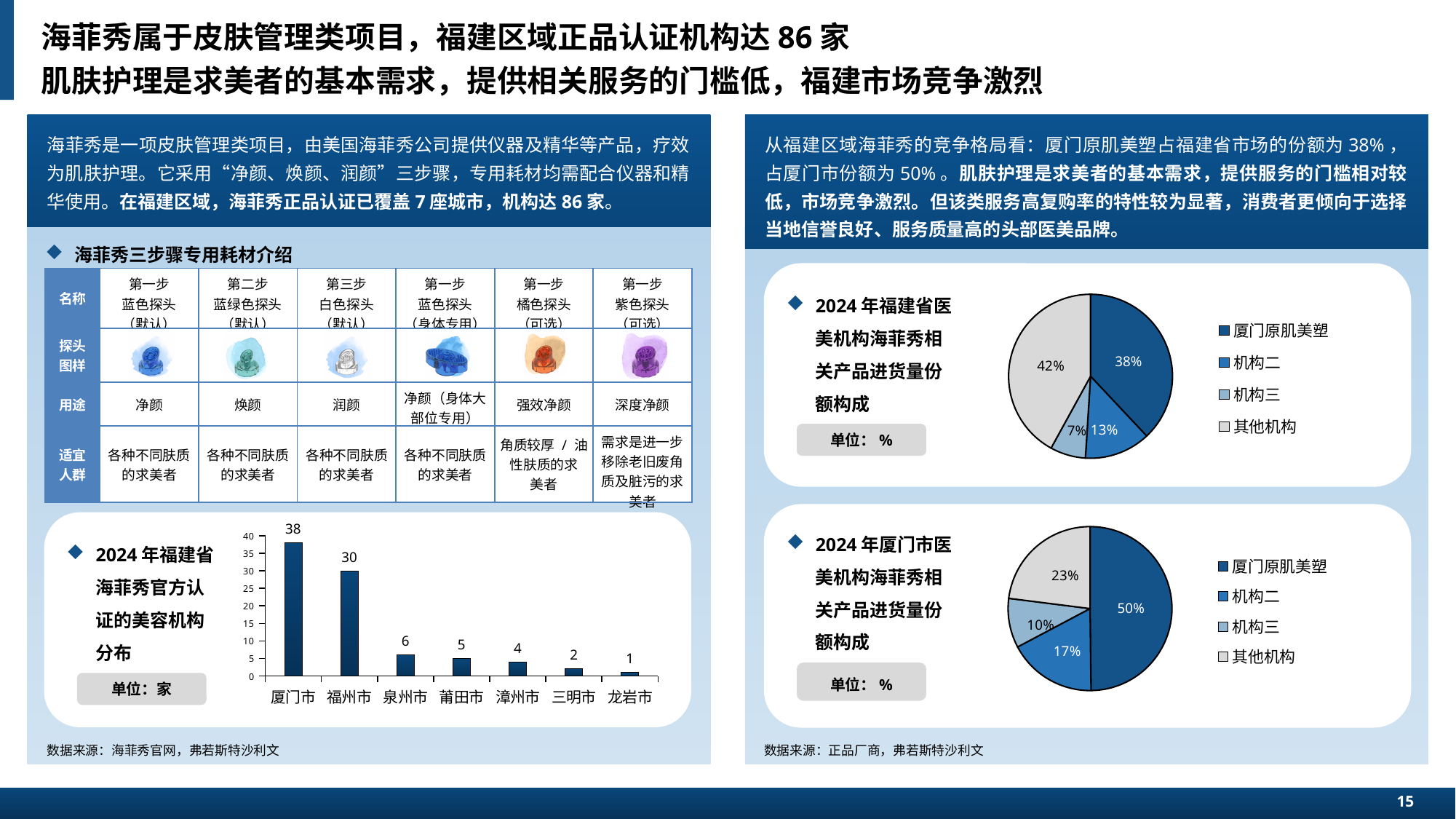
In the bar chart titled 2024年福建省海菲秀官方认证的美容机构分布, do the values rise or fall from left to right? fall In the pie chart titled 2024年厦门市医美机构海菲秀相关产品进货量份额构成, what share does 机构二 have? 17% In the bar chart titled 2024年福建省海菲秀官方认证的美容机构分布, what is the value for 福州市? 30 In the pie chart titled 2024年福建省医美机构海菲秀相关产品进货量份额构成, which slice is the largest? 其他机构 In the pie chart titled 2024年福建省医美机构海菲秀相关产品进货量份额构成, what share does 厦门原肌美塑 have? 38% In the bar chart titled 2024年福建省海菲秀官方认证的美容机构分布, what is the difference between the values for 厦门市 and 福州市? 8 In the pie chart titled 2024年厦门市医美机构海菲秀相关产品进货量份额构成, which is larger, 机构三 or 其他机构? 其他机构 How many entries does the legend of the pie chart titled 2024年厦门市医美机构海菲秀相关产品进货量份额构成 list? 4 In the bar chart titled 2024年福建省海菲秀官方认证的美容机构分布, which city has the lowest value? 龙岩市 What kind of chart is the one titled 2024年福建省海菲秀官方认证的美容机构分布? bar chart In the bar chart titled 2024年福建省海菲秀官方认证的美容机构分布, which city has the highest value? 厦门市 In the bar chart titled 2024年福建省海菲秀官方认证的美容机构分布, how many cities are shown? 7